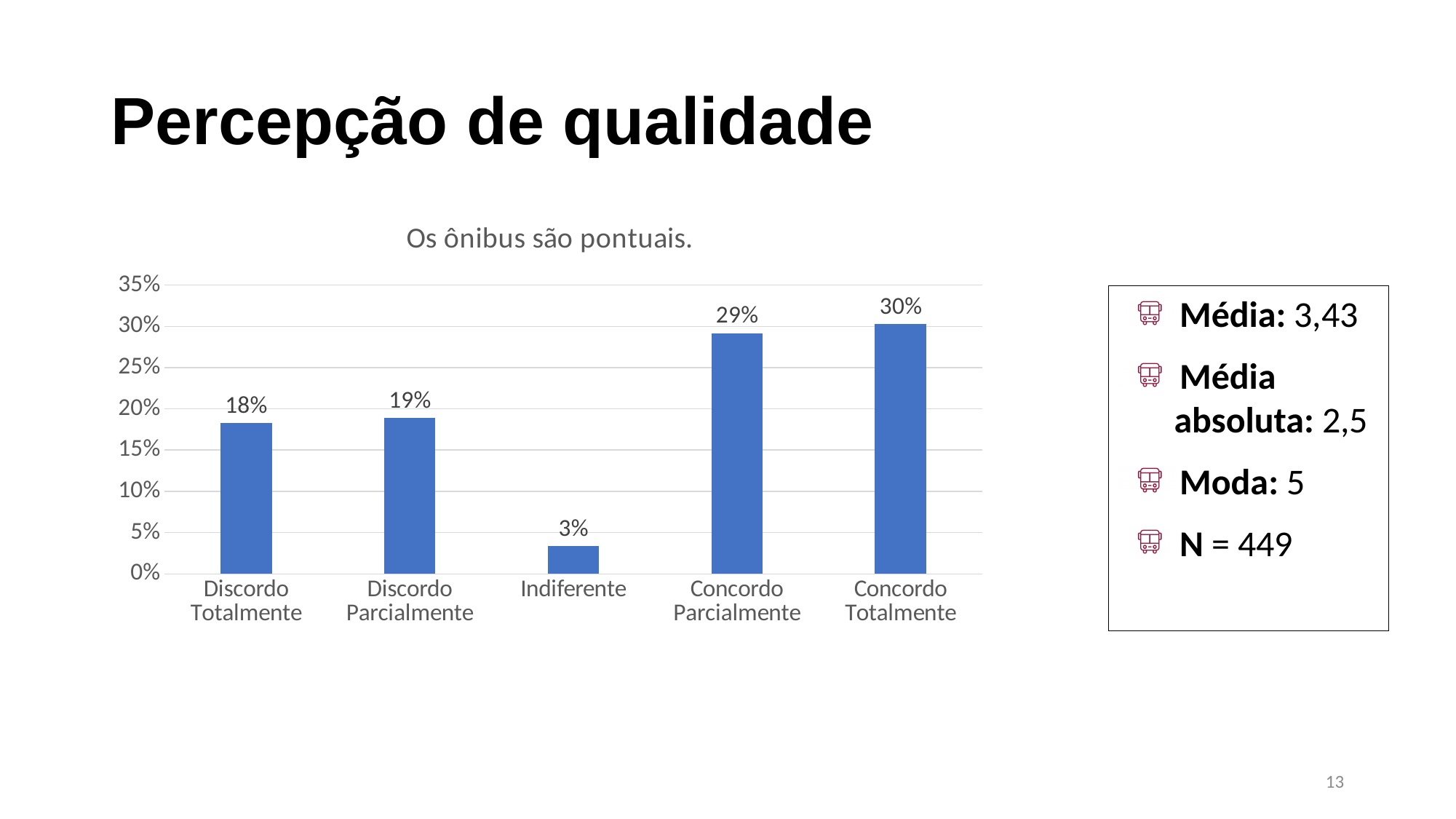
Is the value for Discordo Parcialmente greater or less than 25%? less What is the value for Discordo Totalmente? 18% What is the value for Concordo Parcialmente? 29% What is the value for Concordo Totalmente? 30% How many categories are shown on the x axis? 5 Which category has the highest value? Concordo Totalmente What kind of chart is shown on the slide? bar chart Which category has the lowest value? Indiferente Which is larger, the value for Discordo Parcialmente or the value for Concordo Parcialmente? Concordo Parcialmente What is the title of the chart? Os ônibus são pontuais. What is the value for Indiferente? 3% What is the difference between the values for Concordo Totalmente and Discordo Totalmente? 12%